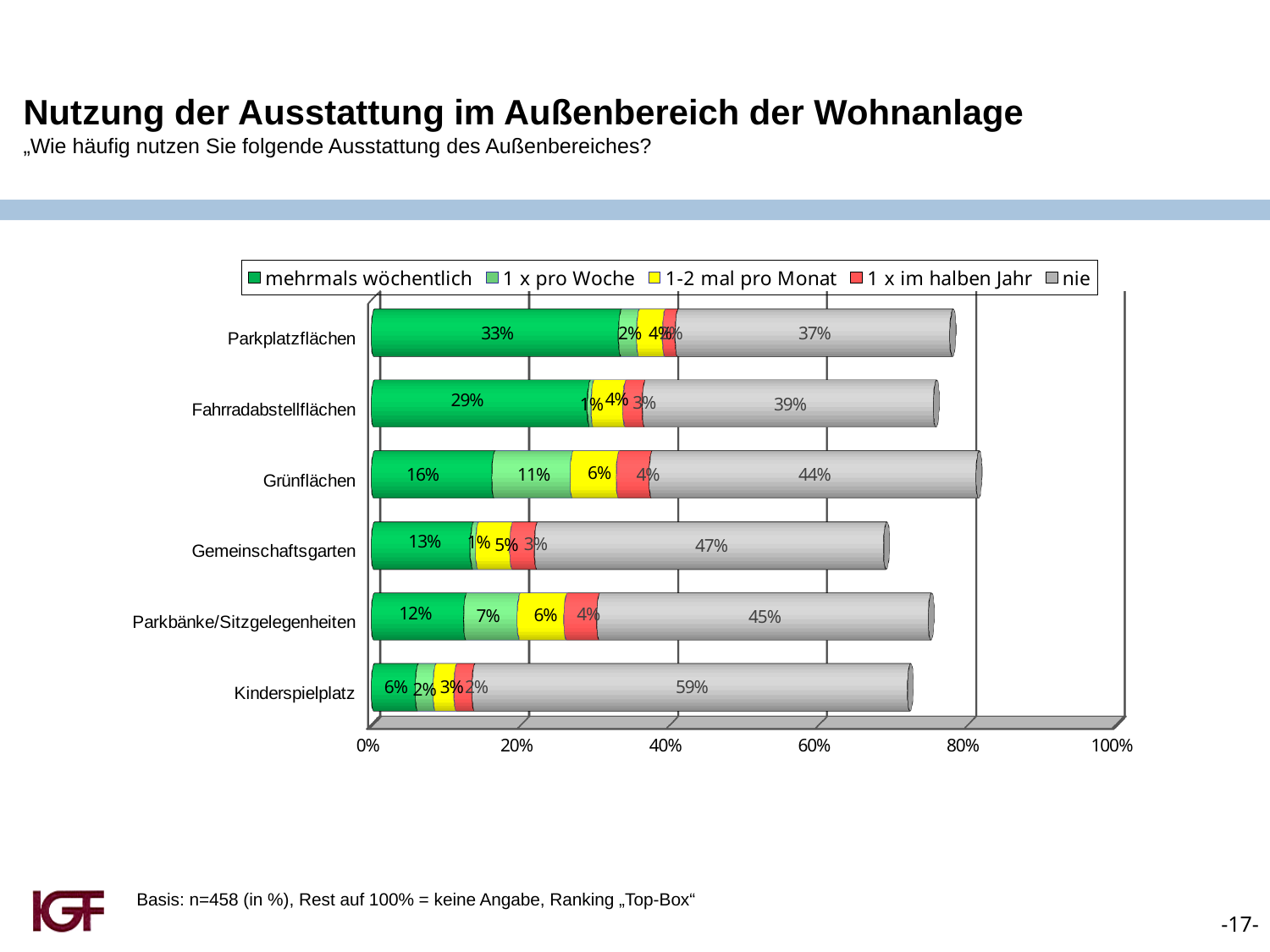
What is the total of the stacked bar for Grünflächen? 81% What is the '1 x pro Woche' value for Grünflächen? 11% Which category has the highest 'nie' share? Kinderspielplatz How many categories (facilities) are shown in the chart? 6 What is the 'nie' value for Kinderspielplatz? 59% What kind of chart is shown on the slide? Stacked bar chart What is the difference between the 'nie' values for Gemeinschaftsgarten and Parkplatzflächen? 10% Which category has the lowest 'mehrmals wöchentlich' share? Kinderspielplatz How many series does the legend list? 5 Which legend entry is shown in red? 1 x im halben Jahr Which is larger: the 'mehrmals wöchentlich' value for Grünflächen or for Parkbänke/Sitzgelegenheiten? Grünflächen What percentage of respondents use the Parkplatzflächen 'mehrmals wöchentlich'? 33%